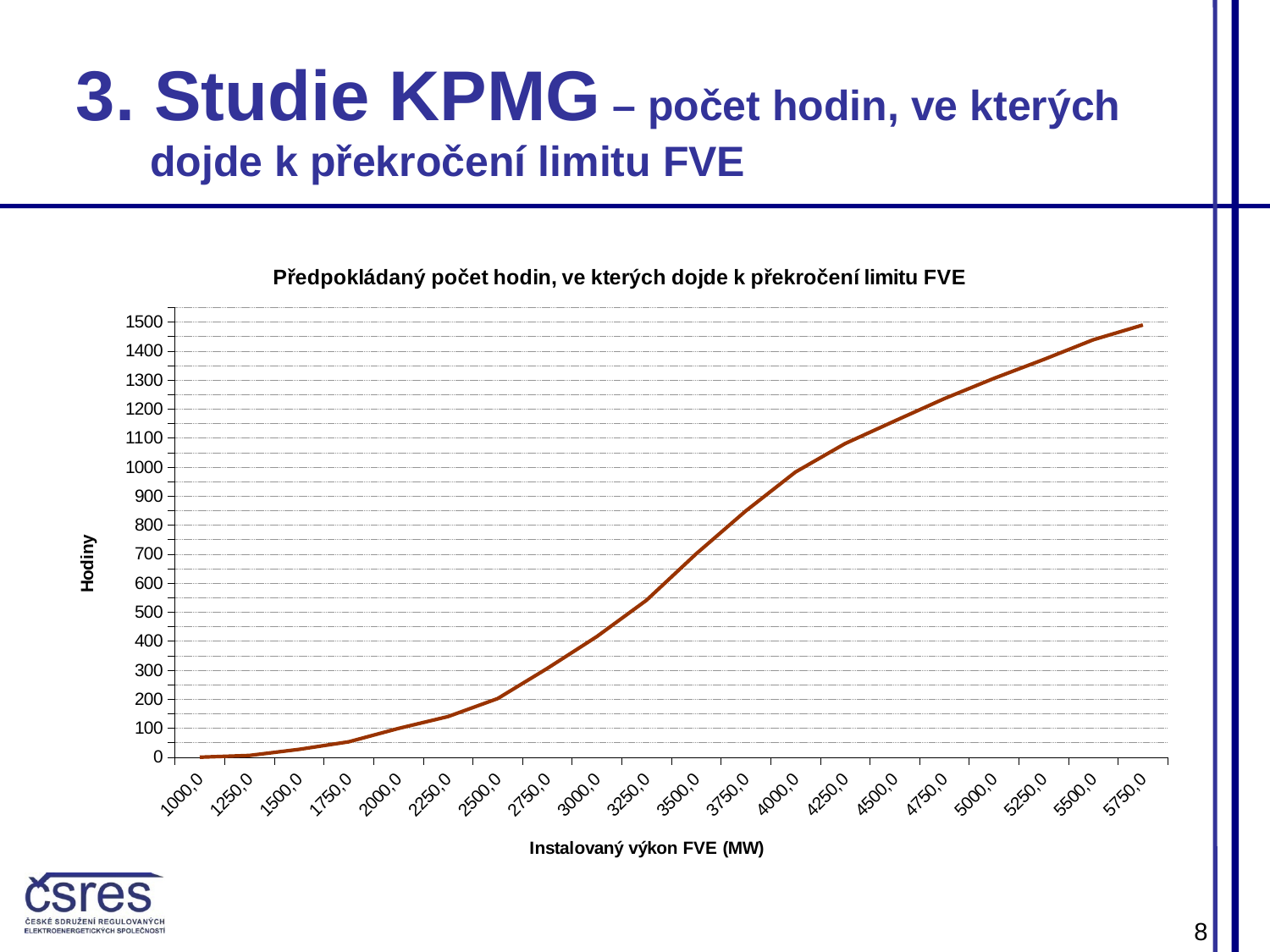
What kind of chart is shown on the slide? line chart Is the value for 1500,0 MW greater or less than 100 hours? less How many installed-capacity values are marked along the x axis of the chart? 20 Do the values on the chart rise or fall as installed capacity increases along the x axis? rise Is the value for 3500,0 MW greater or less than 500 hours? greater What is the title of the chart? Předpokládaný počet hodin, ve kterých dojde k překročení limitu FVE What is the label of the x axis of the chart? Instalovaný výkon FVE (MW) At which installed capacity (MW) is the number of hours highest? 5750,0 Which has the larger value, 3000,0 MW or 4000,0 MW? 4000,0 MW Is the value for 4500,0 MW greater or less than 1000 hours? greater At which installed capacity (MW) is the number of hours lowest? 1000,0